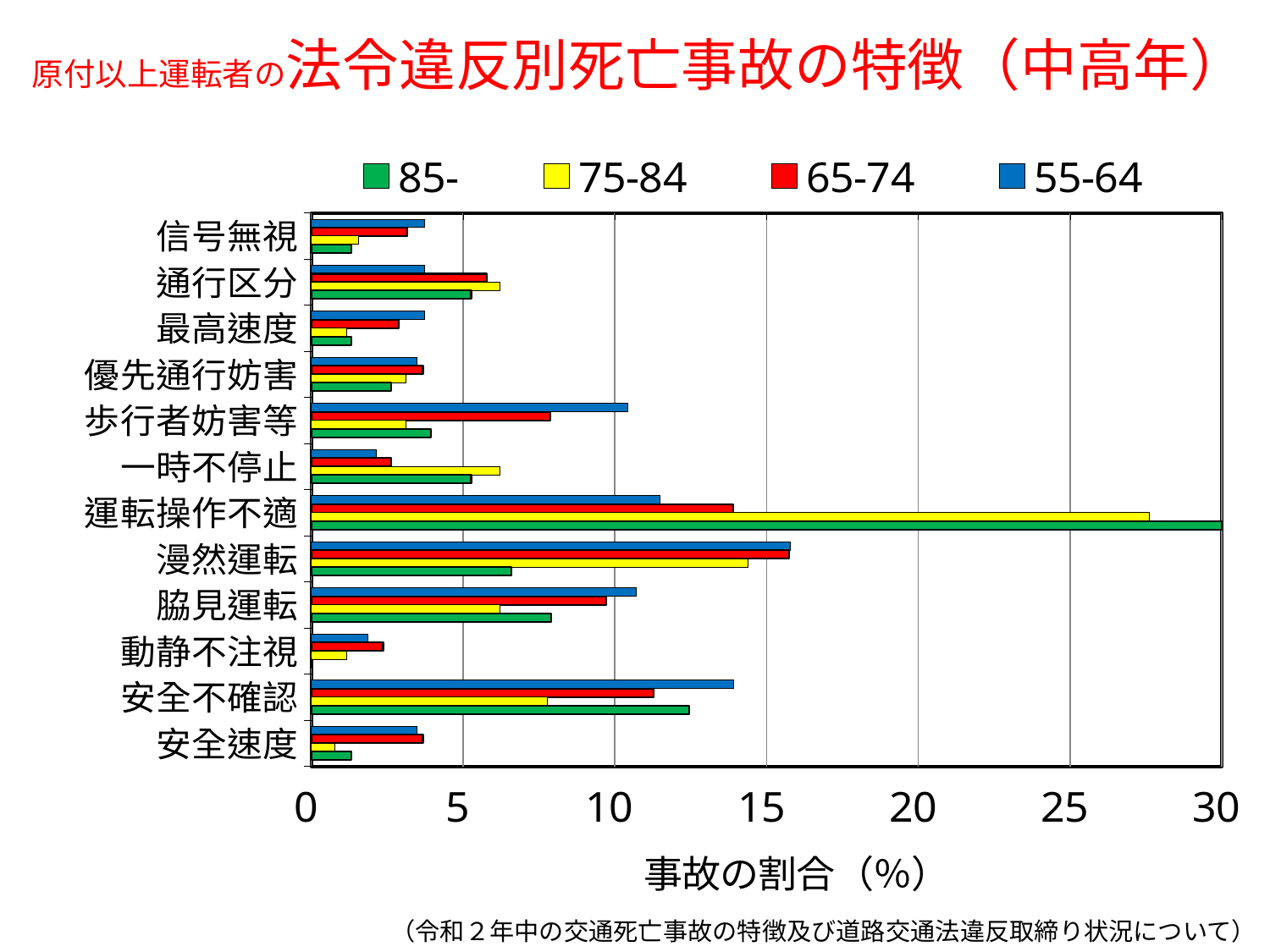
For 一時不停止, which series has the larger value, 75-84 or 55-64? 75-84 How many violation categories are plotted on the y axis? 12 Which category has the highest value for the 85- series? 運転操作不適 What kind of chart is shown on the slide? bar chart Which category has the highest value for the 75-84 series? 運転操作不適 Which category has the highest value for the 55-64 series? 漫然運転 For 安全不確認, which series has the larger value, 55-64 or 85-? 55-64 What is the title of the x axis? 事故の割合（%） Is the value for 動静不注視 in the 55-64 series greater or less than 5? less Is the value for 安全不確認 in the 85- series greater or less than 10? greater Is the value for 運転操作不適 in the 85- series greater or less than 25? greater How many series does the legend list? 4